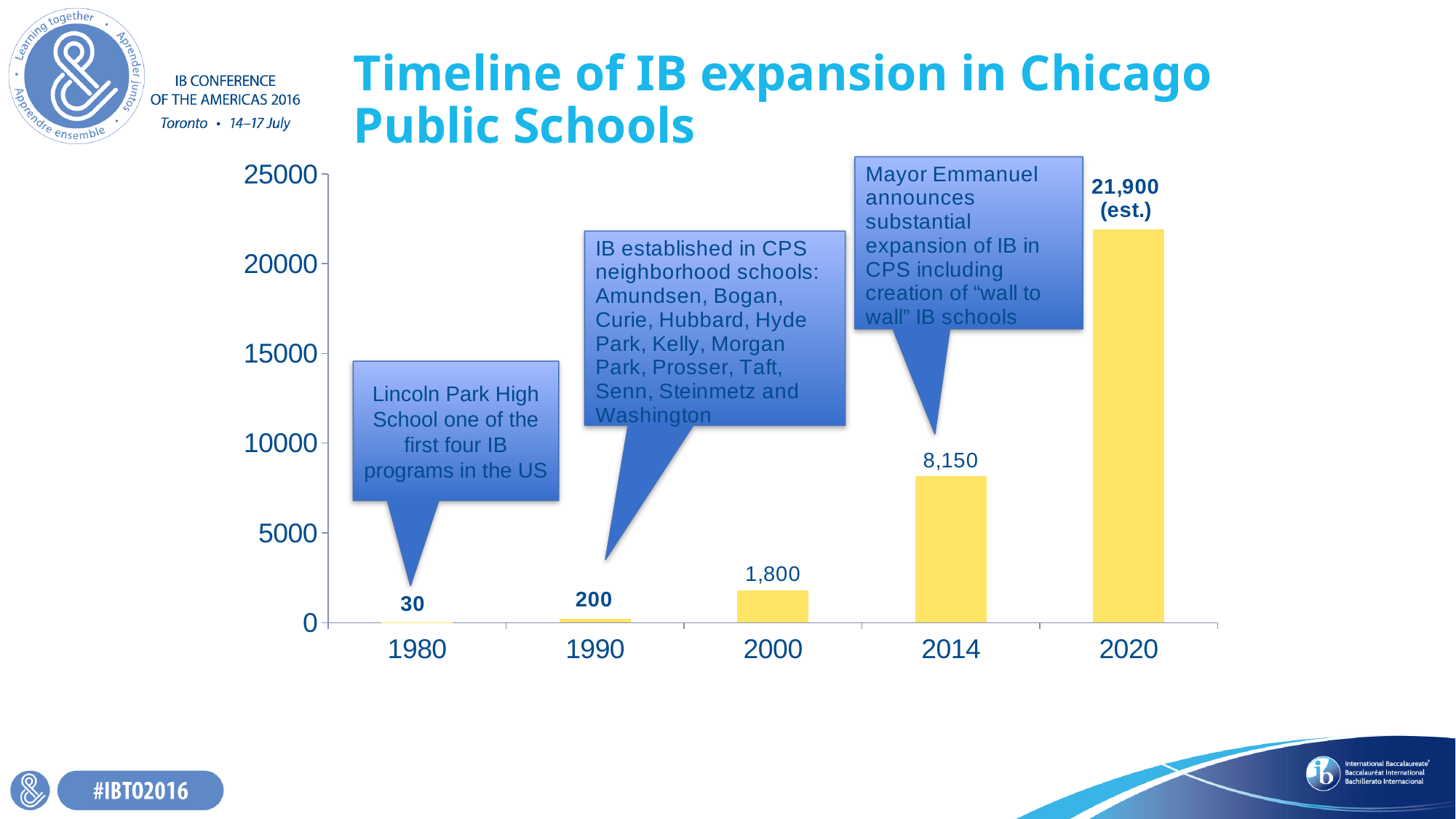
Which is larger, the value for 1990 or the value for 2000? 2000 What is the value shown for 1980? 30 How many years are shown on the x axis? 5 What is the value shown for 2014? 8,150 Is the value for 2020 greater or less than 20000? greater Which year has the lowest value? 1980 What is the difference between the values for 2014 and 2000? 6,350 What is the value shown for 2000? 1,800 What is the value shown for 2020? 21,900 (est.) Do the values rise or fall from 1980 to 2020? Rise What kind of chart is shown on the slide? Bar chart Which year has the highest value? 2020